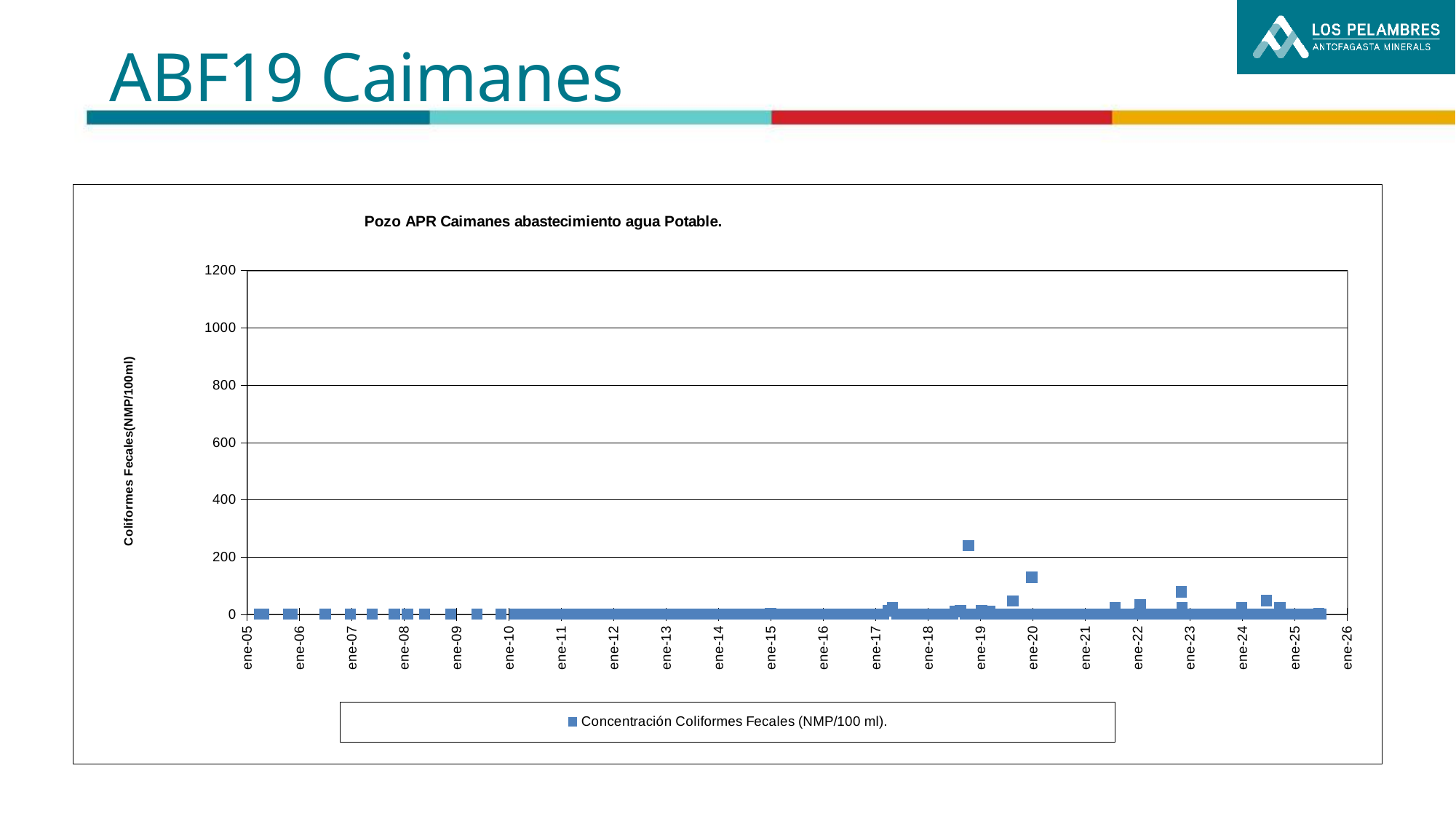
What is the first date label on the horizontal axis? ene-05 What is the last date label on the horizontal axis? ene-26 How many series does the legend list? 1 What is the label of the vertical axis? Coliformes Fecales(NMP/100ml) What kind of chart is shown on the slide? scatter chart What is the title of the chart? Pozo APR Caimanes abastecimiento agua Potable. What is the highest tick value shown on the vertical axis? 1200 Do the plotted values mostly stay near 0 or rise steadily across the years? mostly stay near 0 Is the value plotted at ene-20 greater or less than 100? greater Is the highest plotted value greater or less than 400? less Is the value plotted at ene-20 greater or less than 200? less